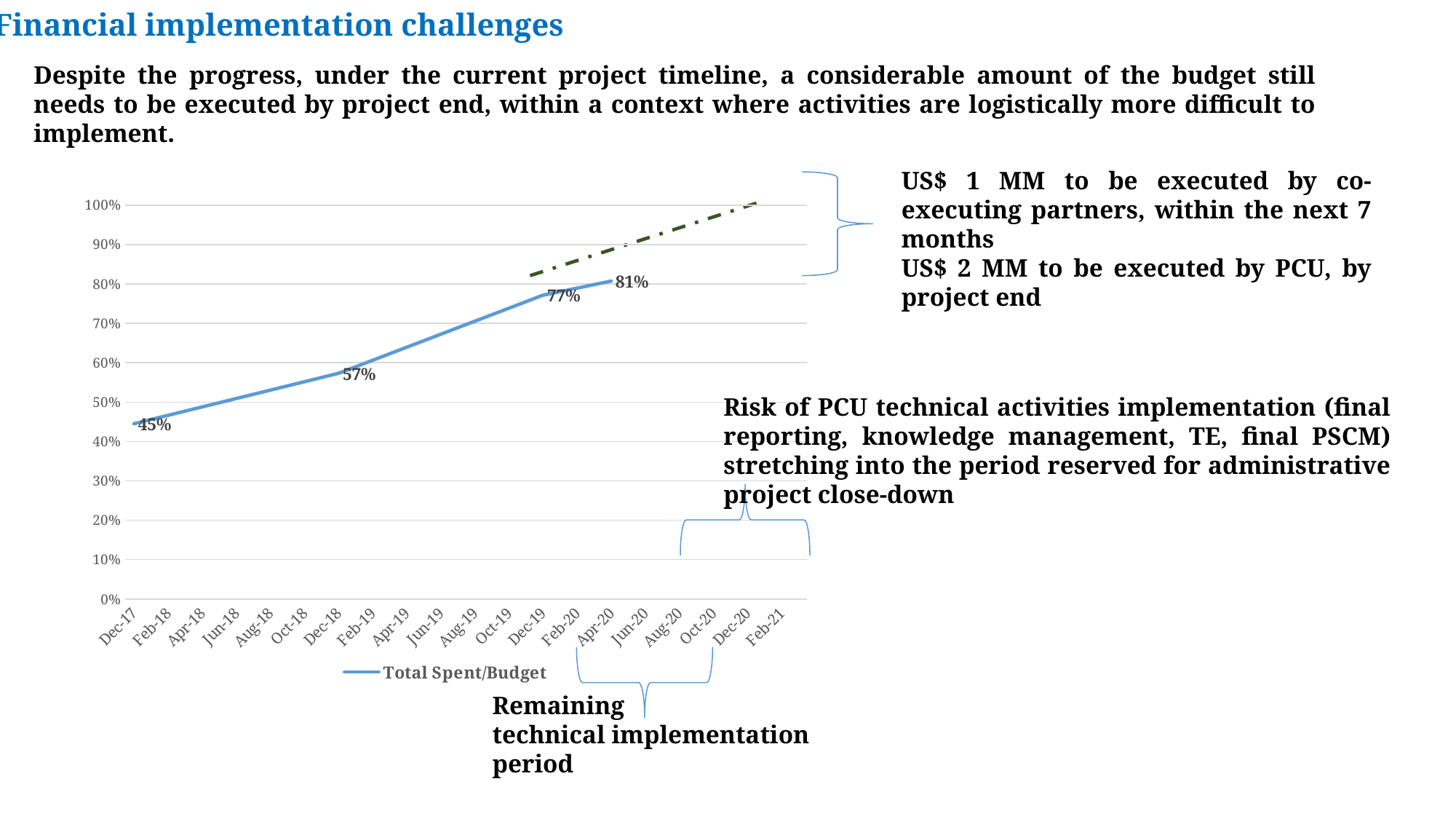
Does the Total Spent/Budget line rise or fall over time? rises Which labelled point on the Total Spent/Budget line has the highest value? Apr-20 (81%) By how many percentage points did Total Spent/Budget increase from Dec-18 to Dec-19? 20 percentage points Which labelled point on the Total Spent/Budget line has the lowest value? Dec-17 (45%) What is the Total Spent/Budget value at Dec-18? 57% What kind of chart is shown on the slide? line chart Is the Total Spent/Budget value at Dec-18 greater or less than 60%? less What is the Total Spent/Budget value at Apr-20? 81% What is the Total Spent/Budget value at Dec-17? 45% What is the Total Spent/Budget value at Dec-19? 77% How many series does the chart legend list? 1 By how many percentage points did Total Spent/Budget increase from Dec-17 to Apr-20? 36 percentage points